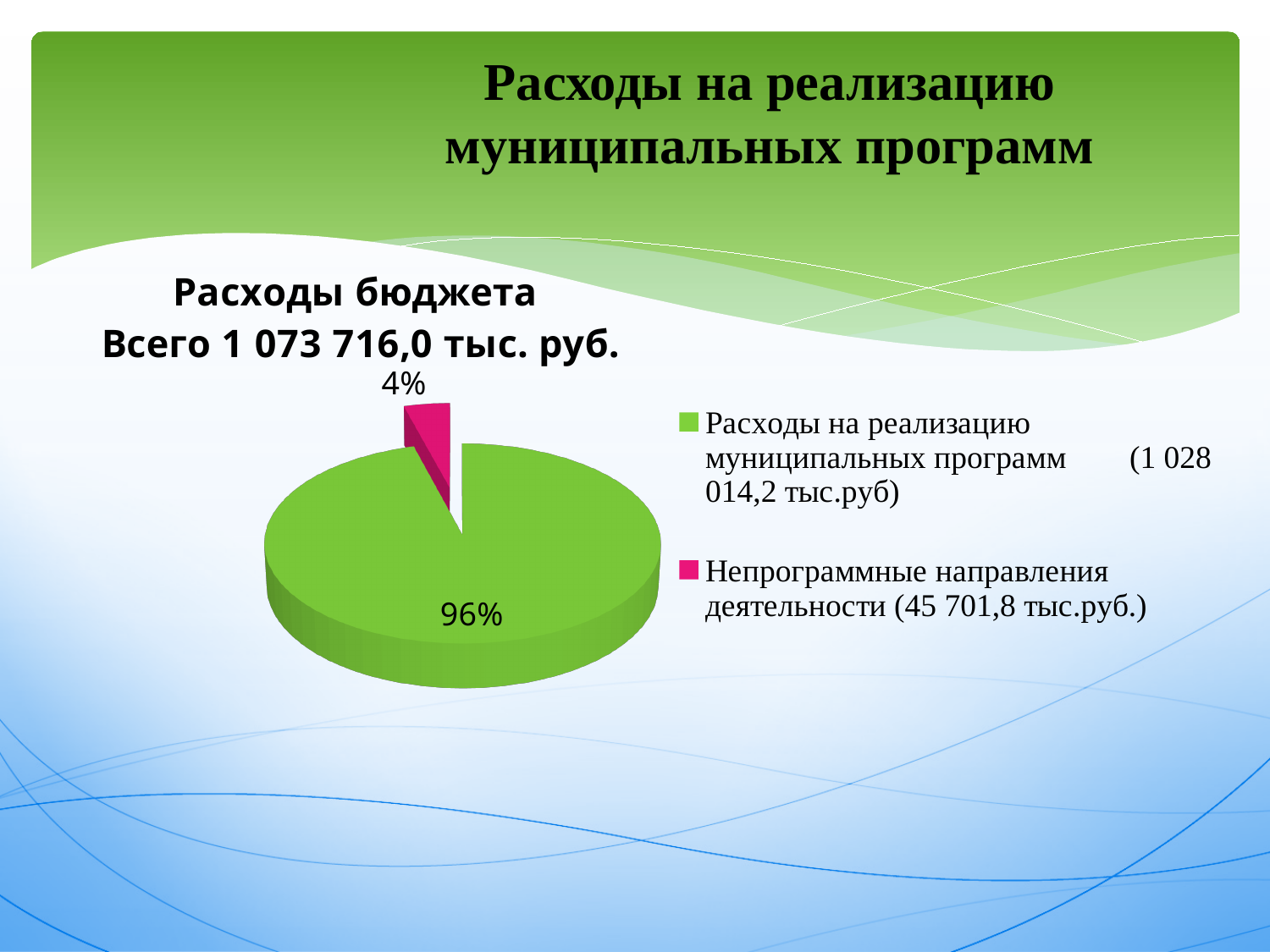
What colour is the slice for "Непрограммные направления деятельности"? pink What total amount is stated in the chart title? 1 073 716,0 тыс. руб. Which slice of the pie is the largest? Расходы на реализацию муниципальных программ What share of the pie does "Непрограммные направления деятельности" take? 4% How many slices does the pie chart have? 2 What type of chart is shown on the slide? pie chart What is the difference in percentage points between the two slices of the pie? 92 According to the legend, what amount corresponds to "Непрограммные направления деятельности"? 45 701,8 тыс.руб. How many entries does the legend list? 2 Which is larger: the share for "Расходы на реализацию муниципальных программ" or the share for "Непрограммные направления деятельности"? Расходы на реализацию муниципальных программ Which slice of the pie is the smallest? Непрограммные направления деятельности What share of the pie does "Расходы на реализацию муниципальных программ" take? 96%